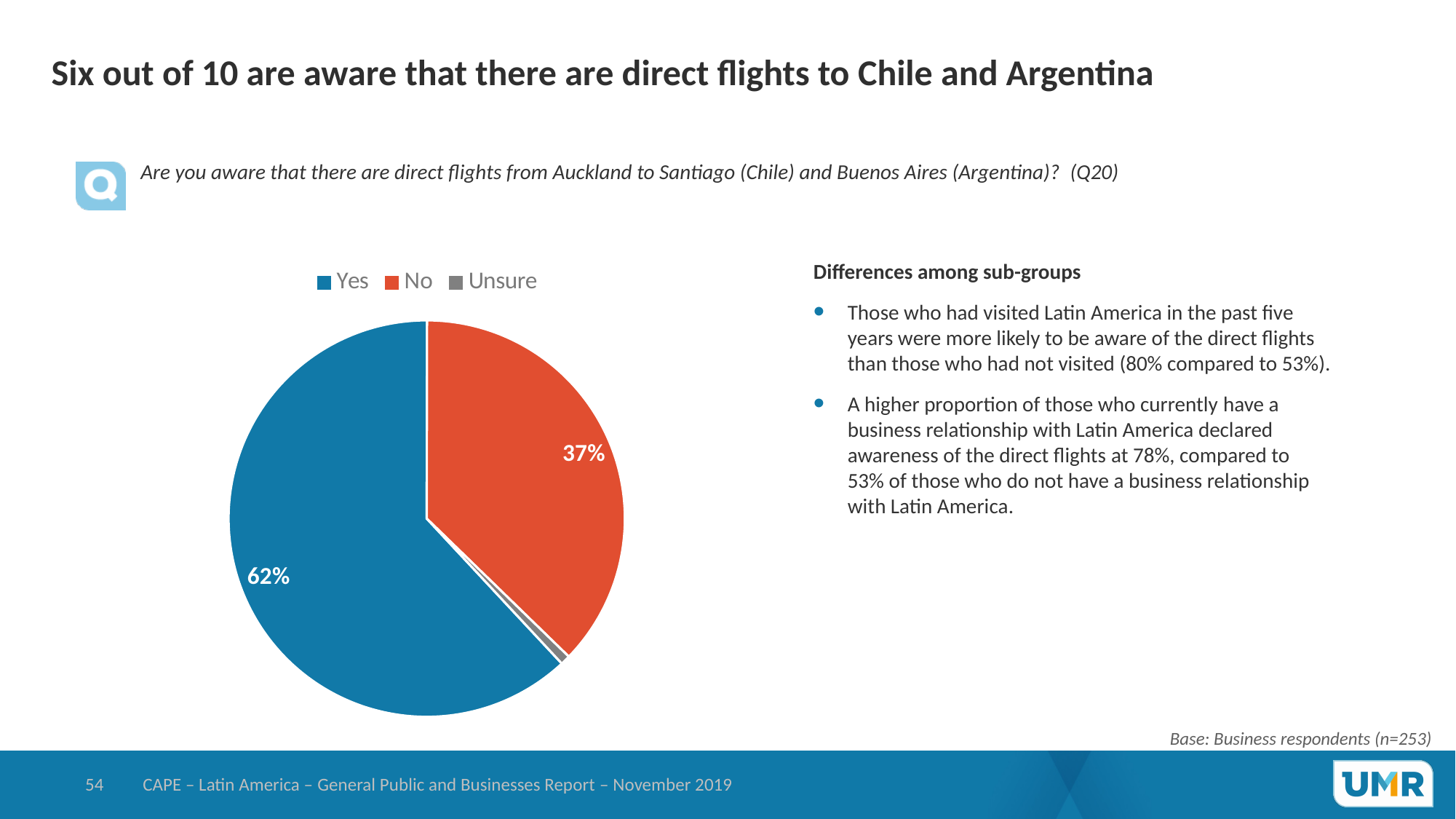
What type of chart is shown on the slide? Pie chart Which is larger, the Yes slice or the No slice? Yes Is the share for Yes greater or less than half of the pie? greater What colour is the Unsure slice? Grey What percentage of respondents answered Yes? 62% What percentage of respondents answered No? 37% What colour is the Yes slice? Blue Which response has the smallest share of the pie? Unsure What is the difference in percentage points between the Yes and No slices? 25 Which response has the largest share of the pie? Yes How many categories does the pie chart show? 3 How many entries does the legend list? 3